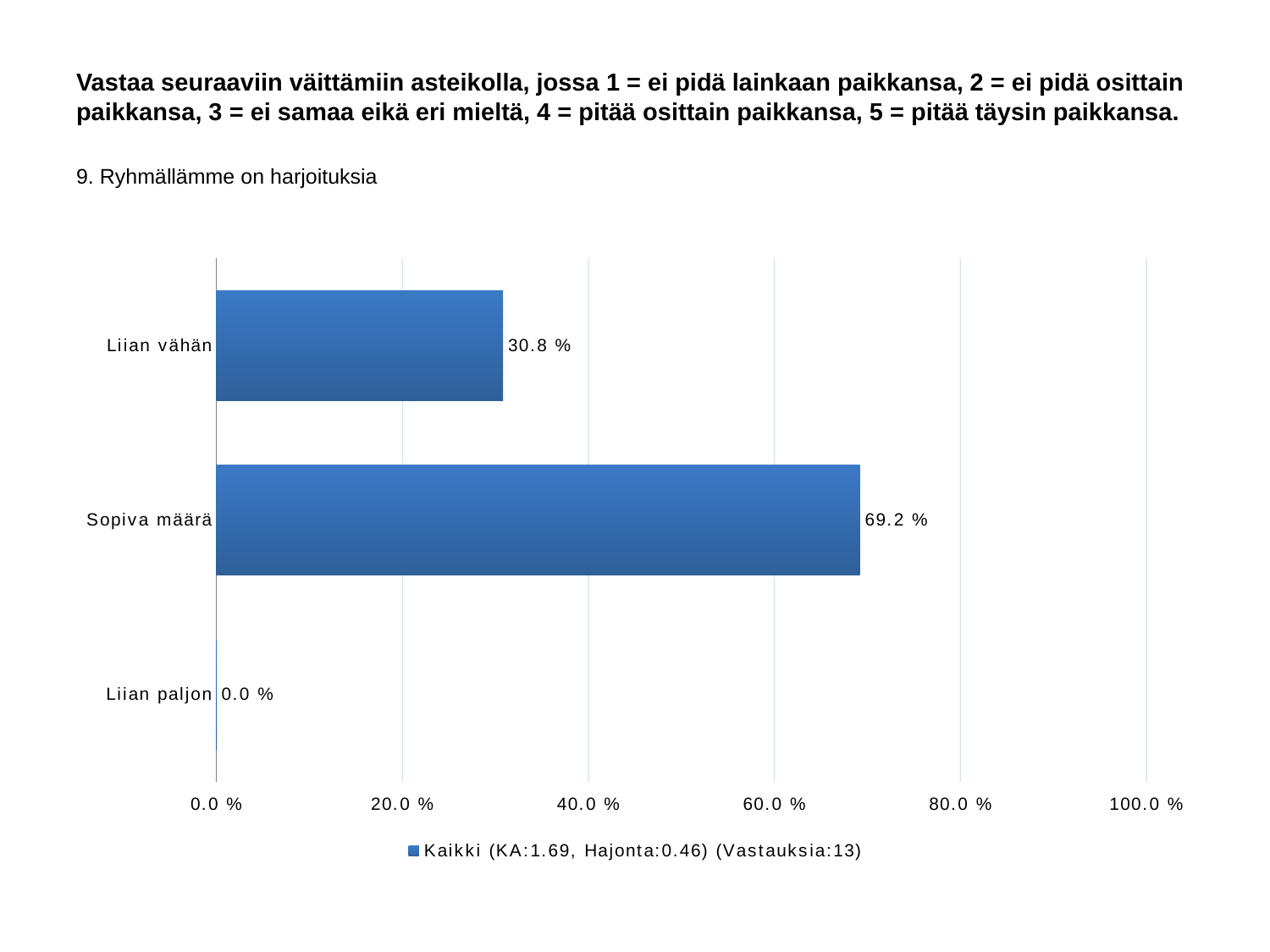
How many categories are shown in the chart? 3 What kind of chart is shown on the slide? Bar chart Which is larger, the value for "Liian vähän" or the value for "Sopiva määrä"? Sopiva määrä What is the value for "Liian vähän"? 30.8 % What is the value for "Liian paljon"? 0.0 % Is the value for "Liian vähän" greater or less than 40.0 %? less Which category has the lowest value? Liian paljon What is the difference between the values for "Sopiva määrä" and "Liian vähän"? 38.4 % What is the value for "Sopiva määrä"? 69.2 % Is the value for "Sopiva määrä" greater or less than 60.0 %? greater Which category has the highest value? Sopiva määrä How many responses (Vastauksia) does the legend report? 13